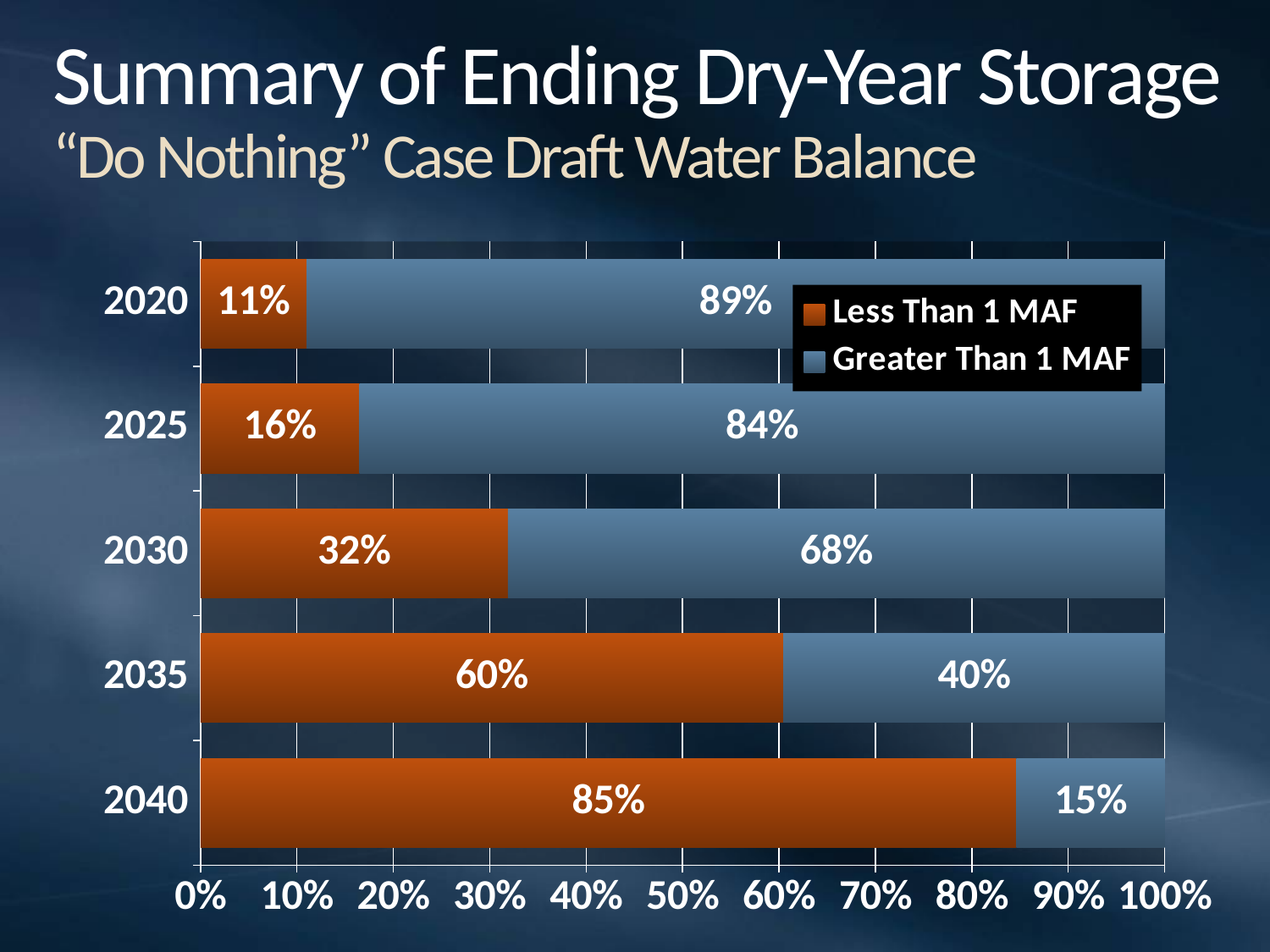
How many years are shown on the chart? 5 What is the difference between the Less Than 1 MAF values for 2035 and 2020? 49% What is the total of the stacked bar for 2030? 100% What is the value for Less Than 1 MAF in 2040? 85% Which is larger in 2035: Less Than 1 MAF or Greater Than 1 MAF? Less Than 1 MAF What is the value for Less Than 1 MAF in 2030? 32% What kind of chart is shown on the slide? Stacked bar chart Which year has the highest value for Less Than 1 MAF? 2040 Which year has the lowest value for Greater Than 1 MAF? 2040 Does the Less Than 1 MAF share rise or fall from 2020 to 2040? Rise What is the value for Greater Than 1 MAF in 2025? 84% How many series does the legend list? 2